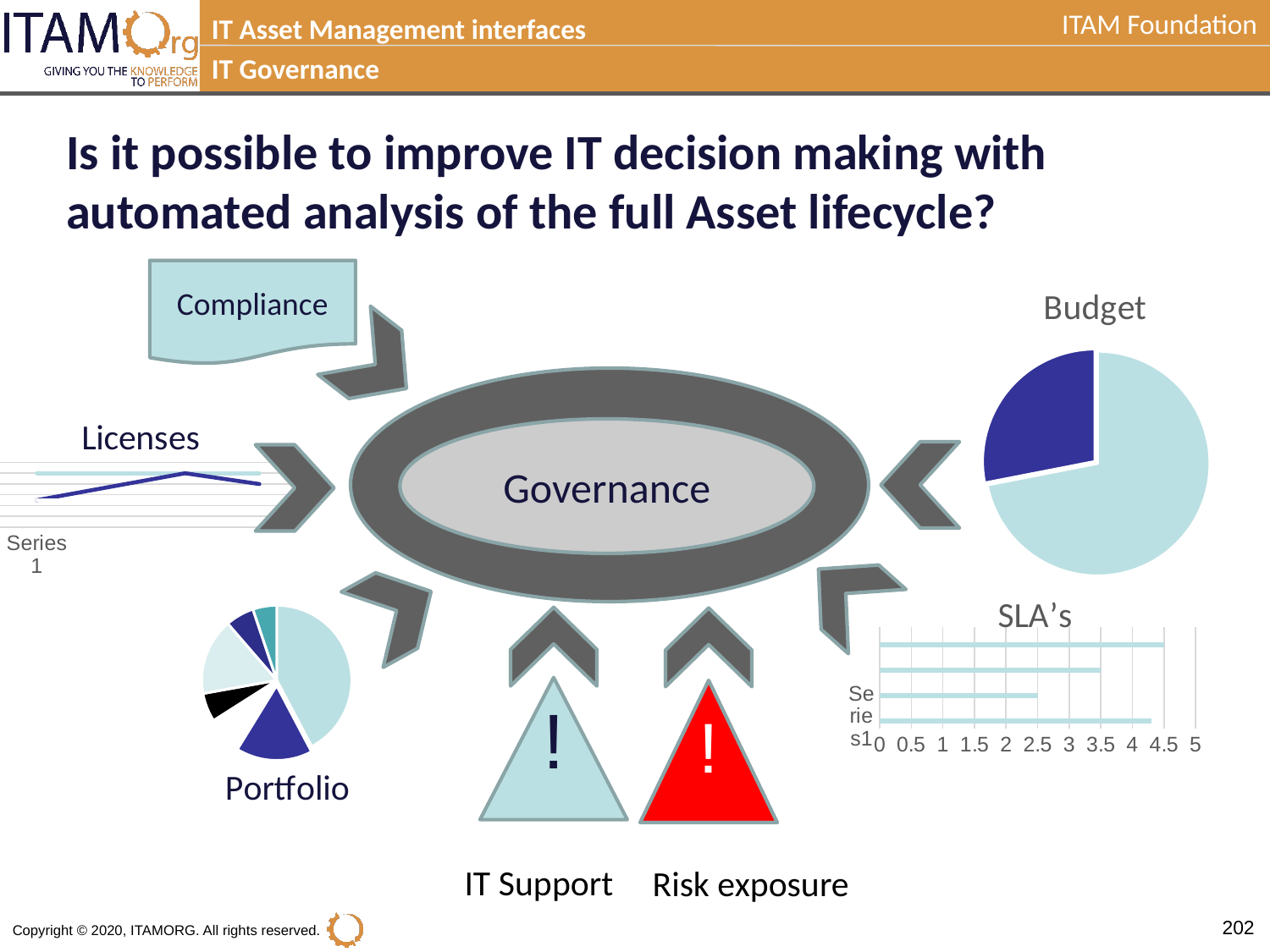
In the Portfolio pie chart, which colour slice is the largest? light blue What kind of chart is the Portfolio chart? pie chart How many slices does the Budget pie chart have? 2 In the SLA's chart, is the value of the top bar greater or less than 4? greater In the Budget pie chart, which slice is larger, the light blue one or the dark blue one? the light blue one In the SLA's chart, is the value of the third bar from the top greater or less than 3? less In the SLA's chart, is the value of the second bar from the top greater or less than 3? greater In the SLA's chart, which bar is the shortest? the third bar from the top What is the highest value shown on the x axis of the SLA's chart? 5 What kind of chart is the SLA's chart? bar chart What kind of chart is the Budget chart? pie chart How many bars does the SLA's chart show? 4